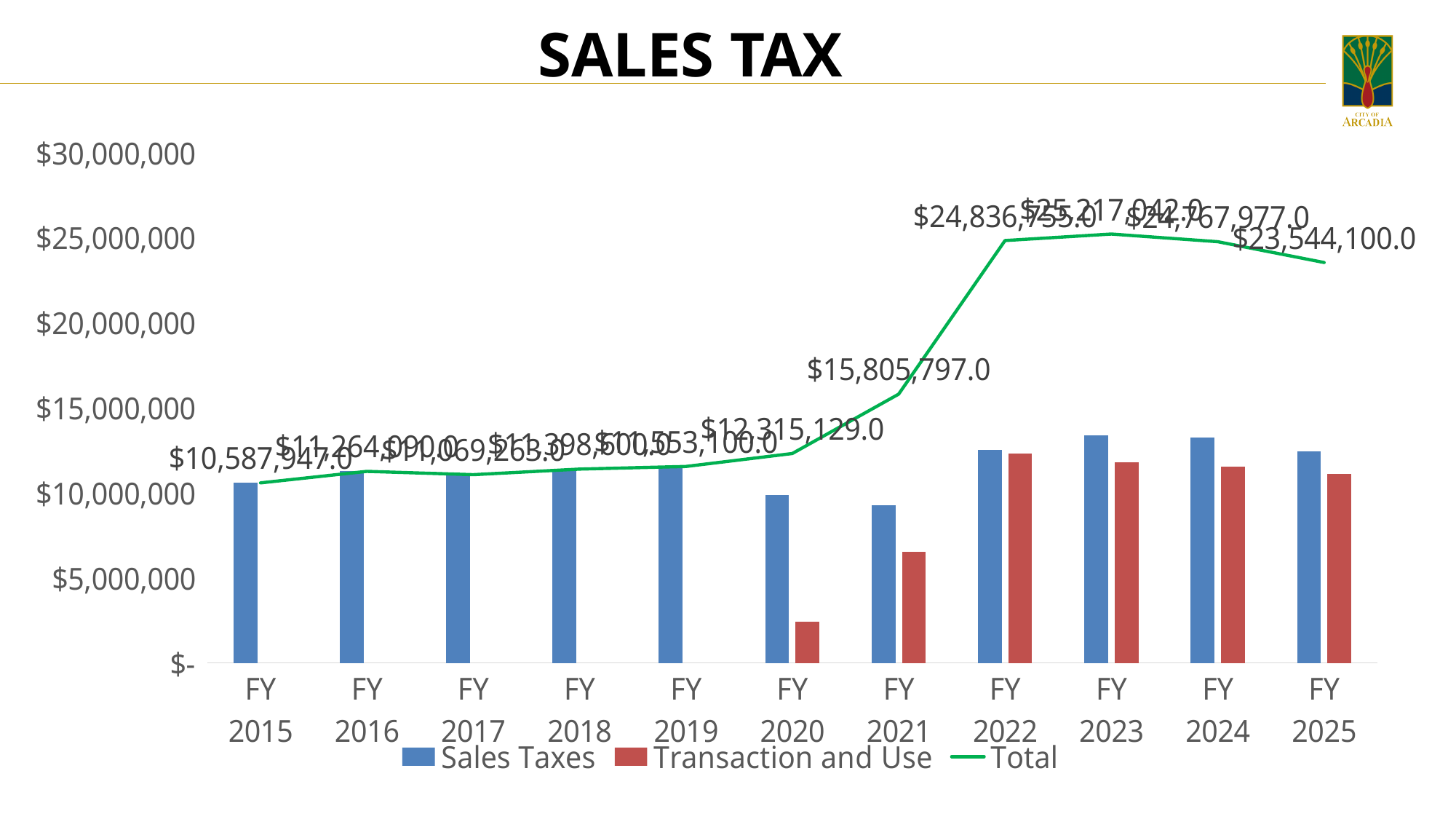
What is the Total value for FY 2015? $10,587,947.0 In which fiscal year is the Total highest? FY 2023 In which fiscal year is the Total lowest? FY 2015 What is the Total value for FY 2025? $23,544,100.0 In FY 2025, which is larger: Sales Taxes or Transaction and Use? Sales Taxes How many fiscal years are shown on the x axis? 11 Is the Transaction and Use value for FY 2020 greater or less than $5,000,000? less How many series does the legend list? 3 By how much did the Total increase from FY 2020 to FY 2021? $3,490,668.0 What is the Total value for FY 2020? $12,315,129.0 What is the Total value for FY 2021? $15,805,797.0 Is the Sales Taxes value for FY 2023 greater or less than $10,000,000? greater